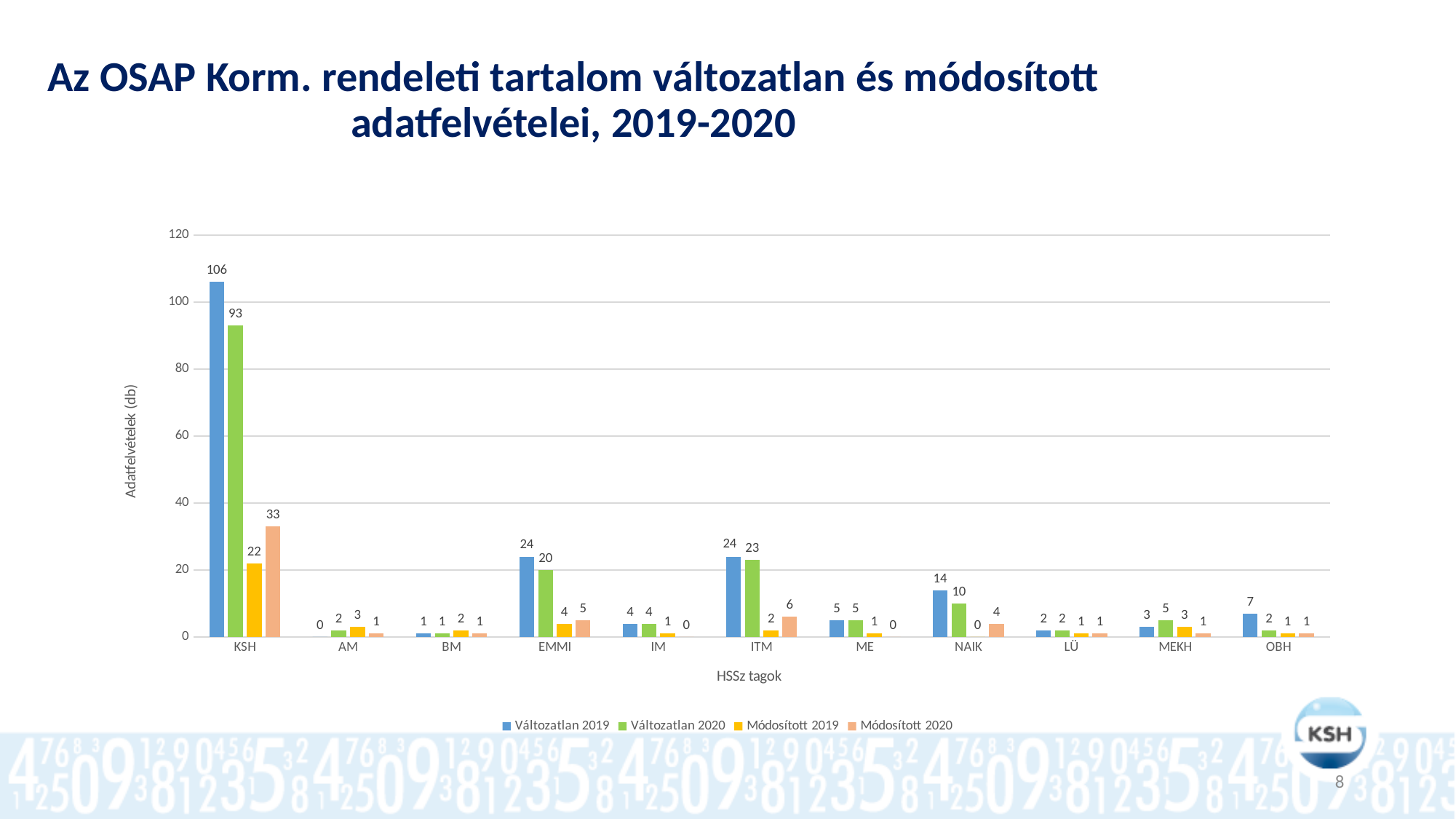
Which category has the highest Változatlan 2019 value? KSH What is the label of the y axis? Adatfelvételek (db) What is the label of the x axis? HSSz tagok How many categories are shown on the x axis? 11 What kind of chart is shown on the slide? Bar chart Which category has the lowest Változatlan 2019 value? AM What is the value of Változatlan 2019 for KSH? 106 How many series does the legend list? 4 What is the value of Változatlan 2020 for NAIK? 10 What is the value of Módosított 2020 for ITM? 6 What is the difference between the Változatlan 2019 and Változatlan 2020 values for KSH? 13 Which is larger for EMMI: Változatlan 2019 or Módosított 2019? Változatlan 2019